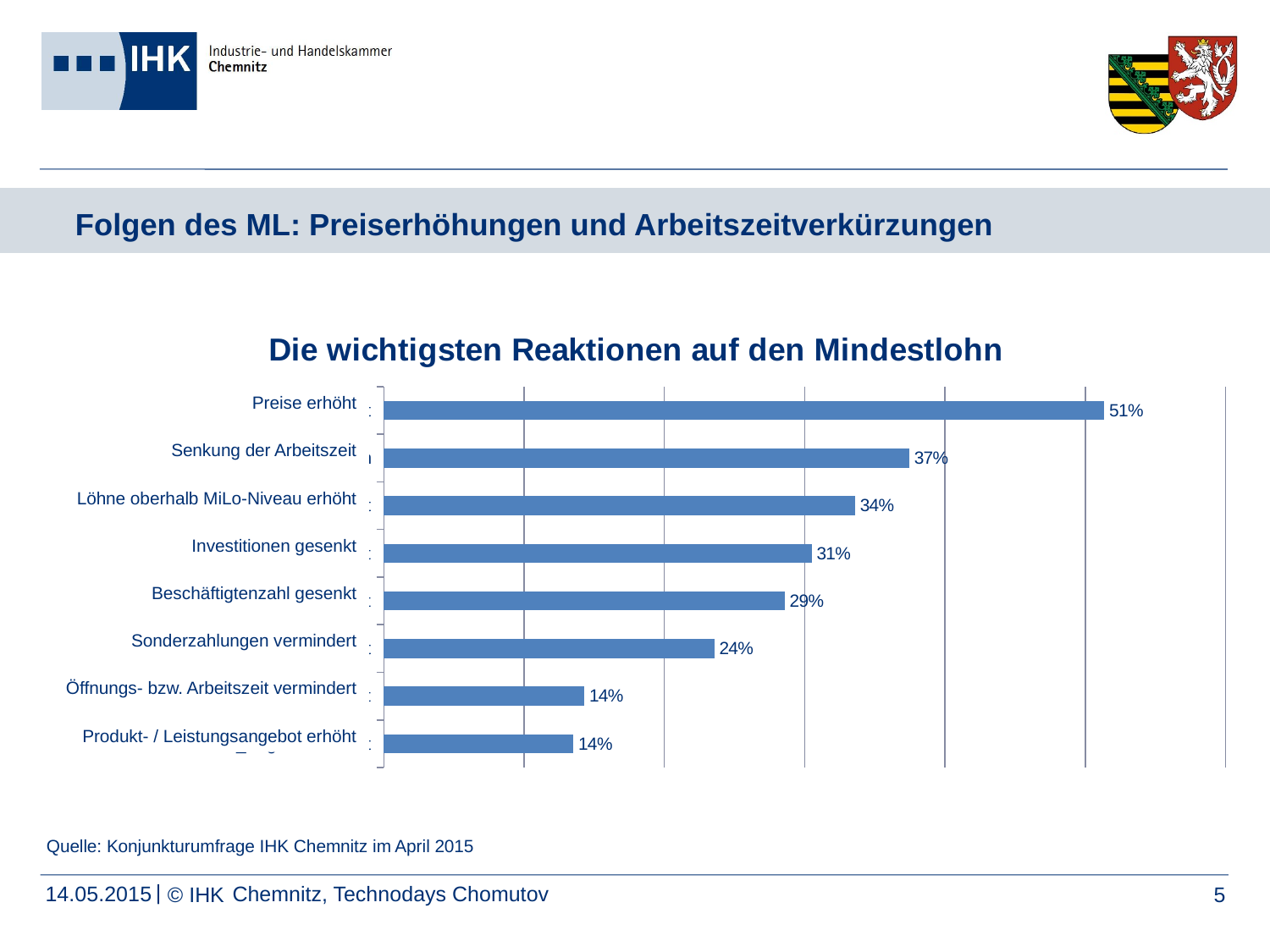
What is the value for "Sonderzahlungen vermindert"? 24% What is the title of the chart? Die wichtigsten Reaktionen auf den Mindestlohn What is the difference between the values for "Preise erhöht" and "Senkung der Arbeitszeit"? 14% How many categories are shown in the chart? 8 What is the value for "Preise erhöht"? 51% What is the value for "Investitionen gesenkt"? 31% What kind of chart is shown on the slide? Bar chart What is the difference between the values for "Löhne oberhalb MiLo-Niveau erhöht" and "Beschäftigtenzahl gesenkt"? 5% What is the value for "Senkung der Arbeitszeit"? 37% Which category has the highest value? Preise erhöht What is the value for "Öffnungs- bzw. Arbeitszeit vermindert"? 14% Which is larger, the value for "Investitionen gesenkt" or the value for "Sonderzahlungen vermindert"? Investitionen gesenkt